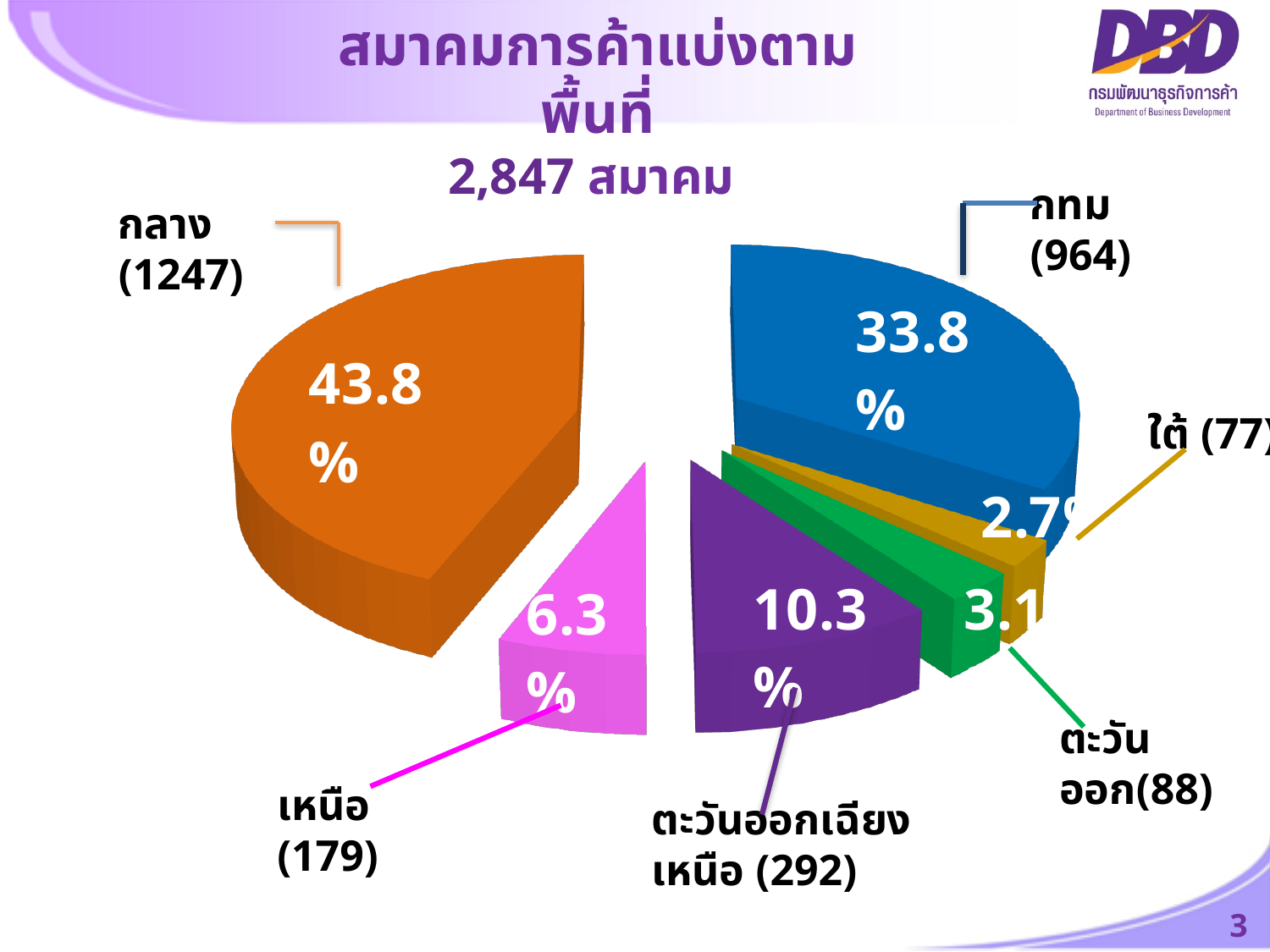
What percentage share does the กทม slice have? 33.8% Which region has the largest slice of the pie? กลาง Which region has the smallest slice of the pie? ใต้ What percentage share does the กลาง slice have? 43.8% How many associations are in the ตะวันออก region according to the label? 88 How many associations are in the ใต้ region according to the label? 77 How many slices does the pie chart have? 6 What is the difference in percentage points between the กลาง slice and the กทม slice? 10.0 percentage points What percentage share does the ตะวันออกเฉียงเหนือ slice have? 10.3% What kind of chart is shown on the slide? pie chart How many associations are in the กลาง region according to the label? 1247